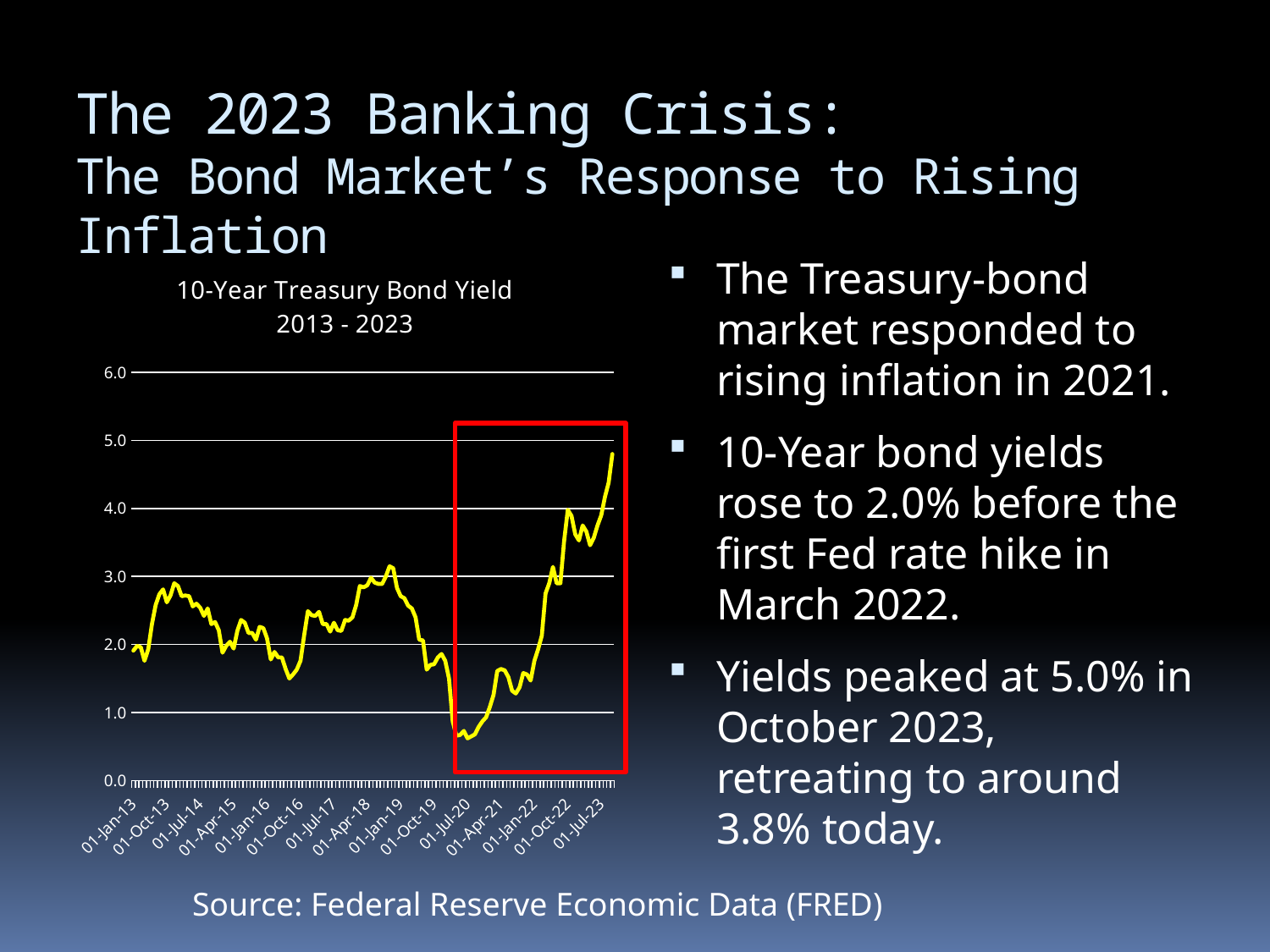
Does the line ever rise above 5.0 on the chart? no Does the line rise above 4.0 at any point on the chart? yes Is the value for 01-Apr-21 greater or less than 2.0? less How many date labels are shown along the x axis? 15 What kind of chart is shown on the slide? line chart What is the highest value shown on the chart's vertical axis? 6.0 In which part of the chart does the line reach its lowest point: around 2020 or around 2013? around 2020 What is the title of the chart? 10-Year Treasury Bond Yield 2013 - 2023 Between 01-Jul-20 and the end of the chart, does the yield generally rise or fall? rise